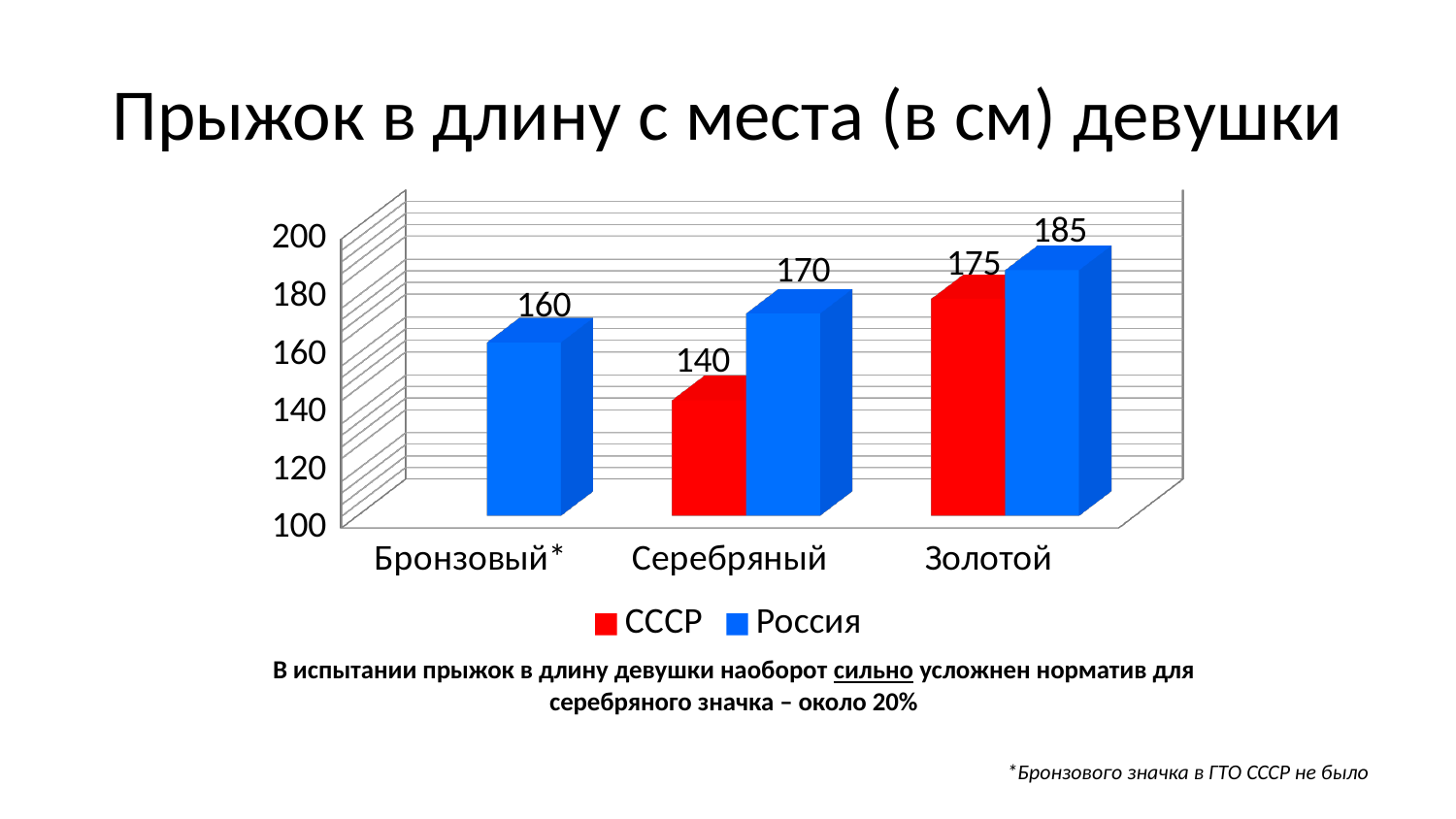
What is the value for СССР in the Серебряный category? 140 Which category has the highest value for the Россия series? Золотой Which is larger in the Золотой category: the СССР value or the Россия value? Россия Which colour represents the СССР series? red What is the value for СССР in the Золотой category? 175 Which category has the lowest value for the Россия series? Бронзовый* How many categories are shown on the x axis? 3 What is the difference between the Россия and СССР values in the Серебряный category? 30 How many series does the legend list? 2 What kind of chart is shown on the slide? bar chart What is the value for Россия in the Бронзовый* category? 160 What is the value for Россия in the Золотой category? 185